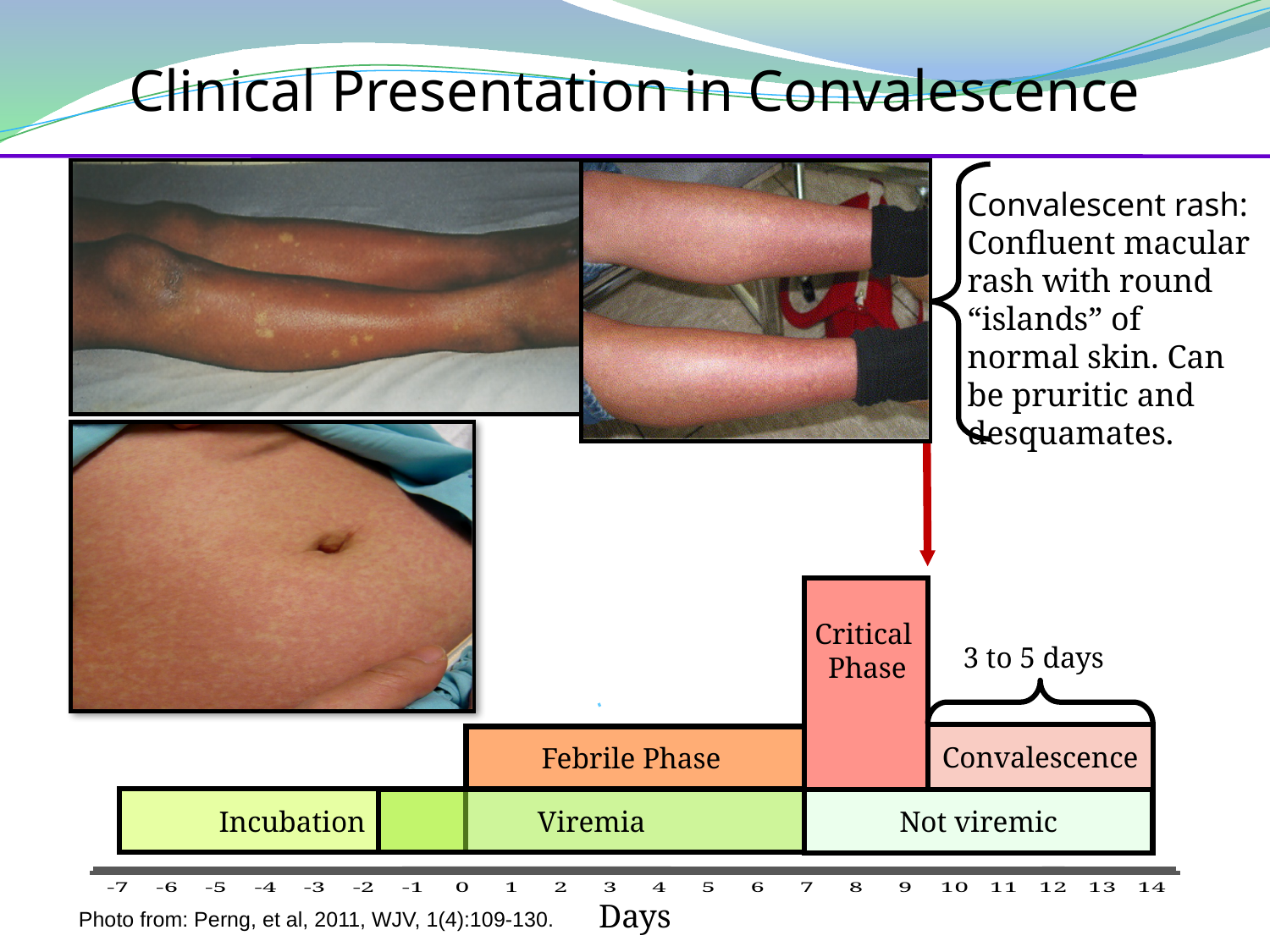
What is the label on the horizontal axis of the timeline diagram? Days What is the highest day value shown on the timeline axis? 14 On the timeline diagram, at which day does the Critical Phase begin? 7 On the timeline diagram, which phase occupies the bottom row from day 7 to day 14? Not viremic On the timeline diagram, at which day does the Febrile Phase begin? 0 On the timeline diagram, which phase is shown between the Febrile Phase and Convalescence? Critical Phase What is the lowest day value shown on the timeline axis? -7 On the timeline diagram, which phase is shown in the bottom row from day -7 to day -1? Incubation On the timeline diagram, which phase is shown in the bottom row from day 0 to day 7? Viremia On the timeline diagram, what duration is indicated above the Convalescence bar? 3 to 5 days